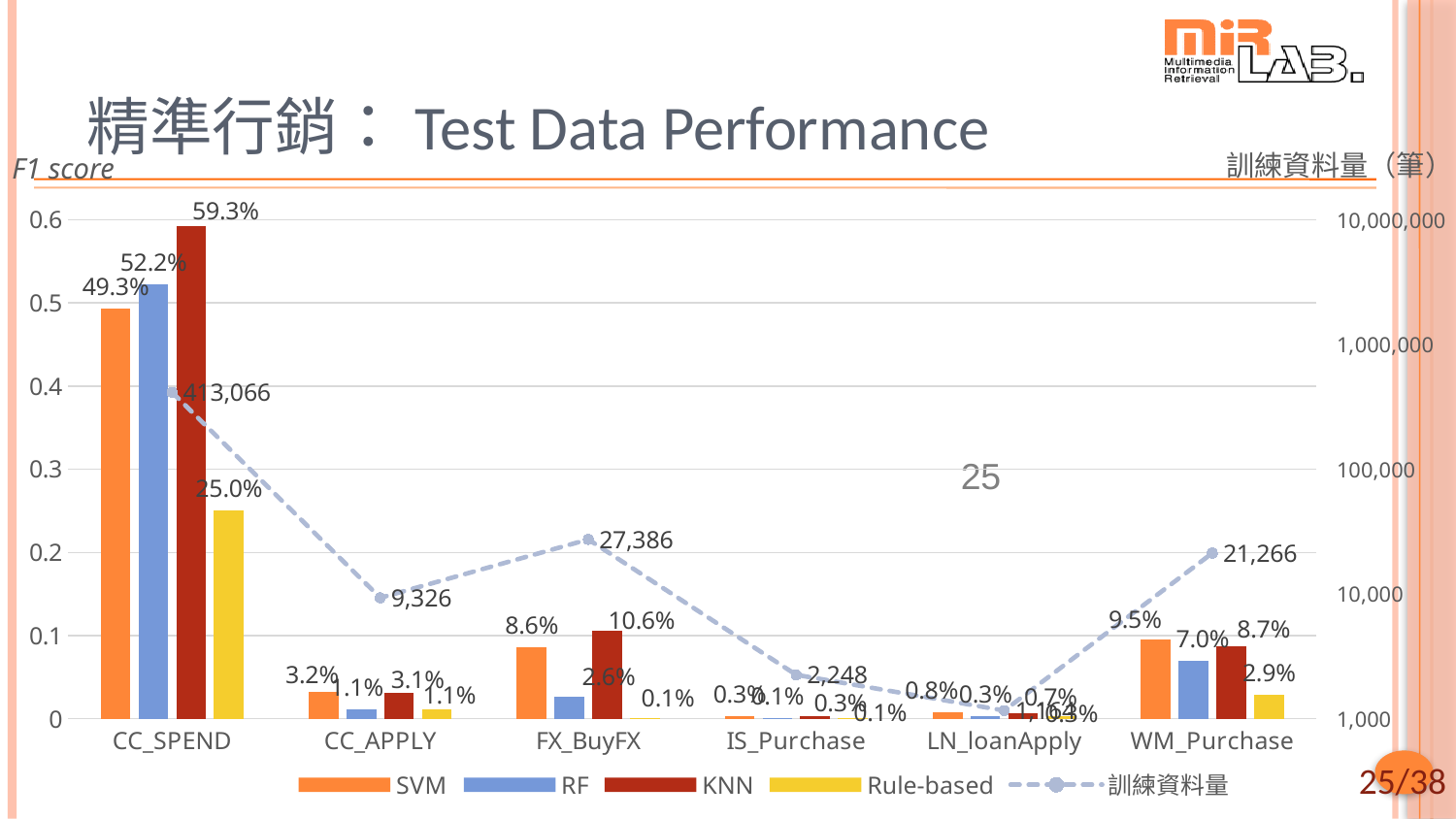
Which category has the highest KNN value? CC_SPEND How many series does the legend list? 5 What is the training data amount (訓練資料量) for FX_BuyFX? 27,386 What is the difference between the RF and SVM values for CC_SPEND? 2.9% What is the KNN F1 score for CC_SPEND? 59.3% What is the Rule-based value for WM_Purchase? 2.9% What kind of chart is this? Bar chart combined with a line chart Is the training data amount for CC_SPEND greater or less than 100,000? greater For WM_Purchase, which is larger: the SVM value or the KNN value? SVM What is the SVM value for FX_BuyFX? 8.6% How many categories are shown on the x axis? 6 Which category has the lowest training data amount (訓練資料量)? LN_loanApply